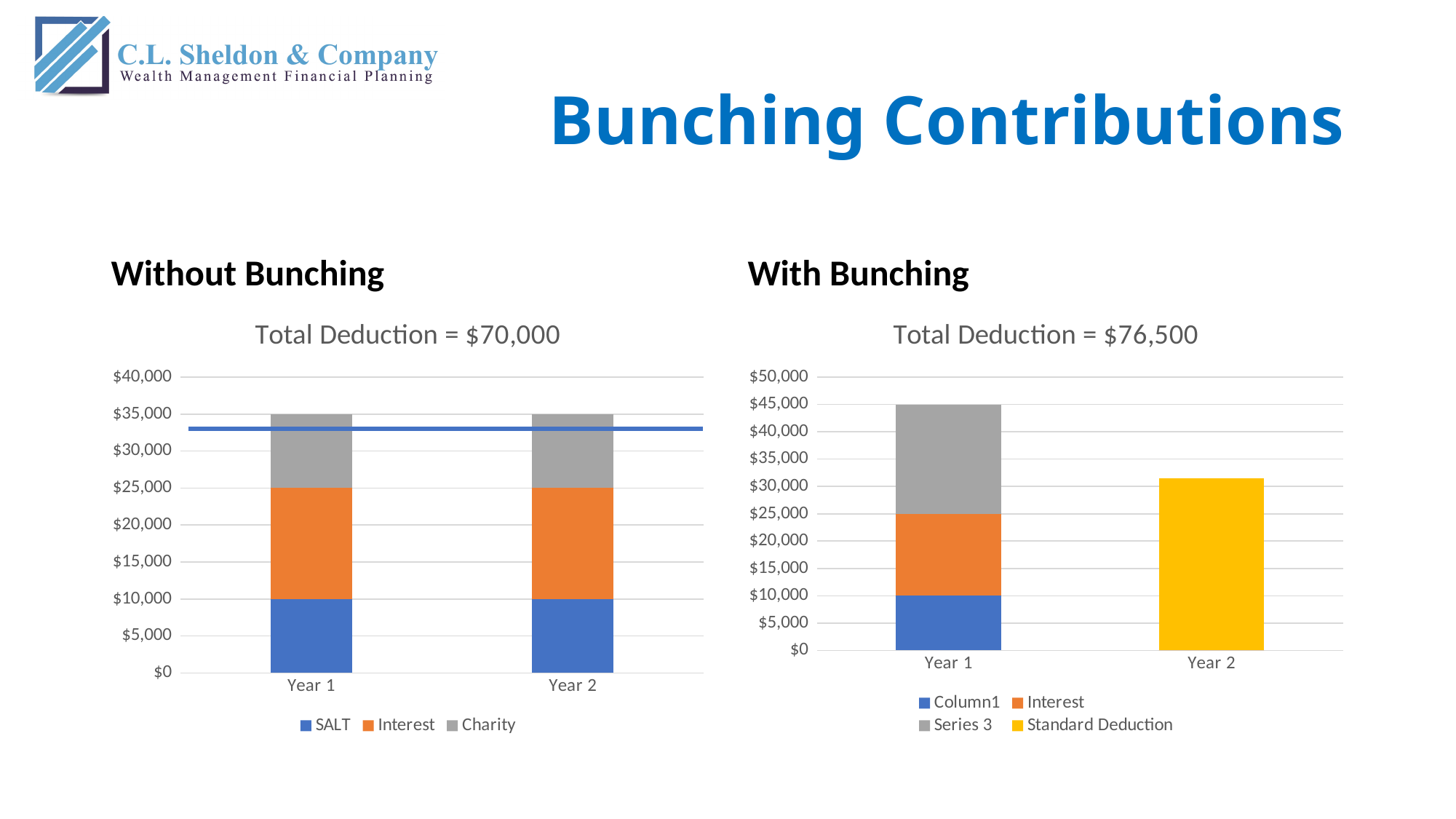
Which legend entry in the right chart is shown in yellow? Standard Deduction In the right chart ('Total Deduction = $76,500'), which bar is taller, Year 1 or Year 2? Year 1 In the left chart, do the stacked bar totals rise, fall, or stay the same from Year 1 to Year 2? Stay the same How many series does the legend of the right chart ('Total Deduction = $76,500') list? 4 How many categories are shown on the x axis of the left chart ('Total Deduction = $70,000')? 2 In the right chart ('Total Deduction = $76,500'), is the value for Year 2 greater or less than $30,000? greater What is the title of the chart under the heading 'With Bunching'? Total Deduction = $76,500 In the left chart ('Total Deduction = $70,000'), what is the total height of the stacked bar for Year 1? $35,000 How many series does the legend of the left chart ('Total Deduction = $70,000') list? 3 What kind of chart is the 'Total Deduction = $70,000' chart on the left? Bar chart In the left chart ('Total Deduction = $70,000'), what is the SALT value for Year 1? $10,000 In the right chart ('Total Deduction = $76,500'), what is the total height of the stacked bar for Year 1? $45,000